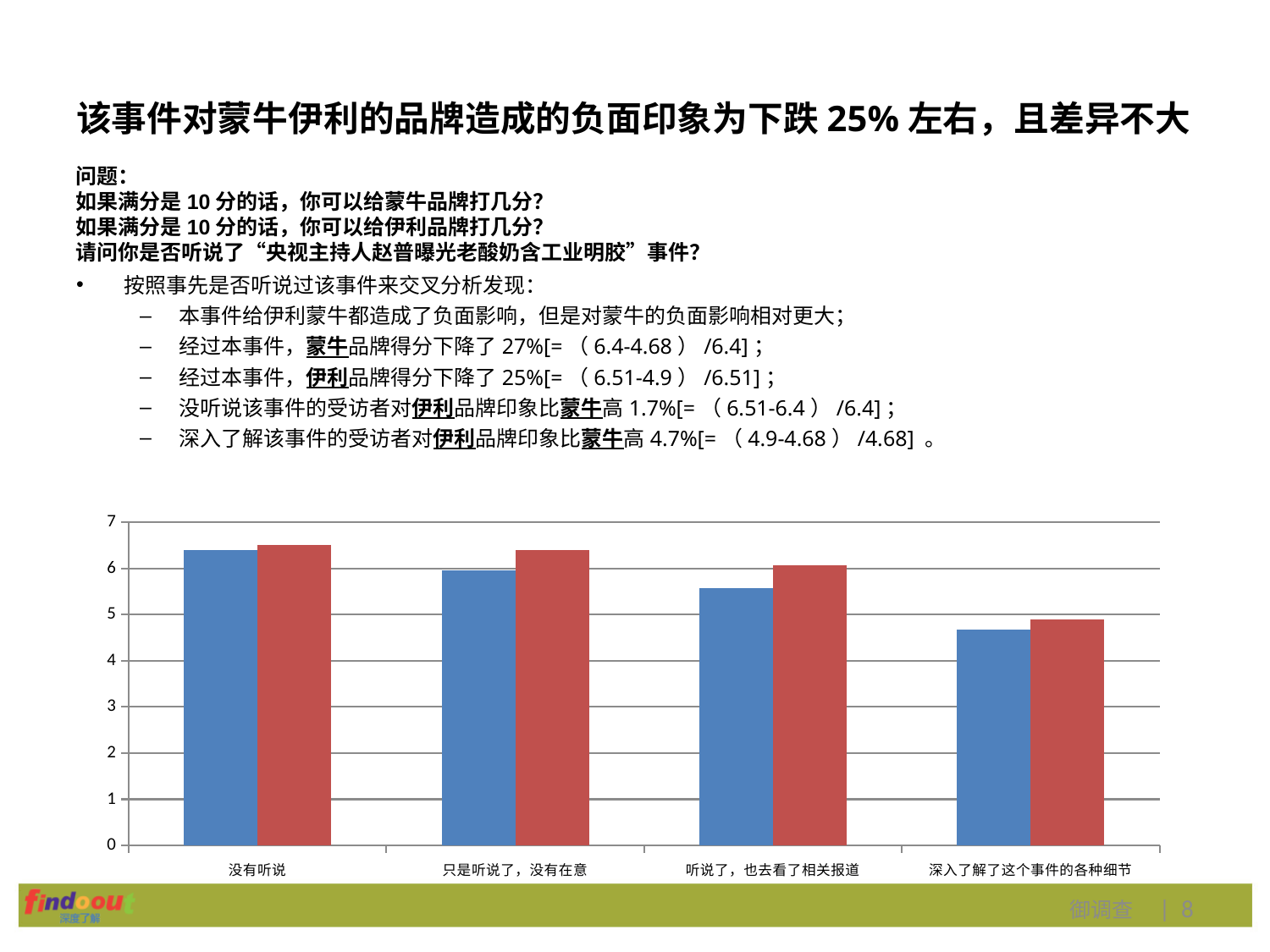
How many bars are plotted for each category in the chart? 2 How many categories are shown on the x axis of the chart? 4 Is the blue bar for 听说了，也去看了相关报道 greater or less than 6? less Which is larger: the blue bar for 没有听说 or the blue bar for 深入了解了这个事件的各种细节? 没有听说 Is the blue bar for 没有听说 greater or less than 6? greater Which category has the lowest blue bar? 深入了解了这个事件的各种细节 Is the blue bar for 深入了解了这个事件的各种细节 greater or less than 5? less Do the blue bars rise or fall from left to right across the categories? fall What kind of chart is shown on the slide? bar chart Which category has the highest red bar? 没有听说